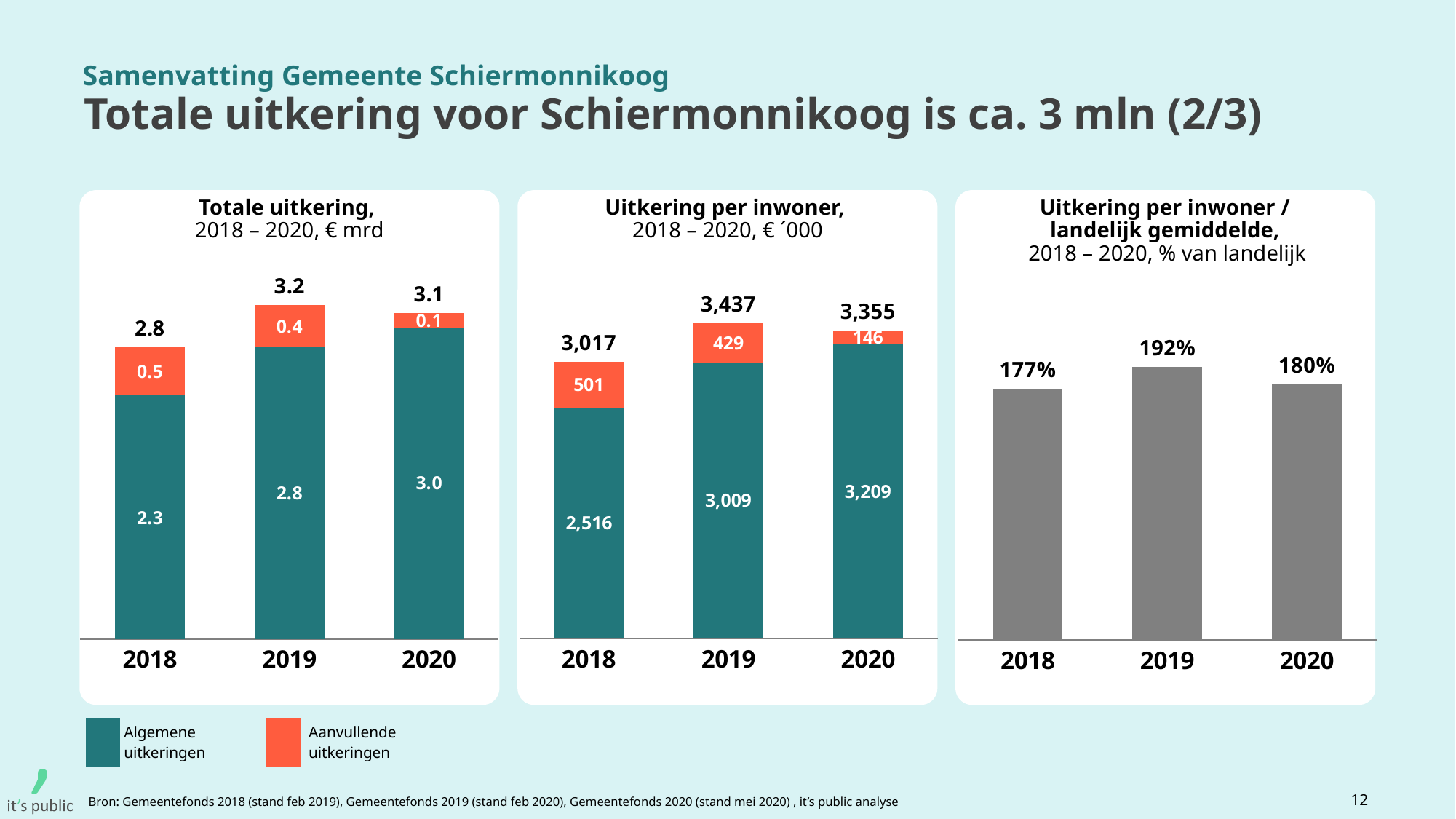
In the 'Uitkering per inwoner' chart, what is the total for 2018? 3,017 In the 'Uitkering per inwoner' chart, what is the value of Algemene uitkeringen in 2020? 3,209 How many series does the legend at the bottom of the slide list? 2 In the 'Totale uitkering' chart, what is the value of Algemene uitkeringen in 2018? 2.3 In the 'Uitkering per inwoner / landelijk gemiddelde' chart, is the value for 2019 larger than the value for 2020? Yes In the 'Uitkering per inwoner / landelijk gemiddelde' chart, which year has the lowest value? 2018 In the 'Uitkering per inwoner' chart, which year has the highest total? 2019 In the 'Totale uitkering' chart, what is the total for 2019? 3.2 In the 'Totale uitkering' chart, what is the value of Aanvullende uitkeringen in 2020? 0.1 In the 'Uitkering per inwoner' chart, what is the difference between the Aanvullende uitkeringen values for 2018 and 2019? 72 How many years are shown on the x axis of the 'Totale uitkering' chart? 3 In the 'Uitkering per inwoner / landelijk gemiddelde' chart, what is the value for 2020? 180%